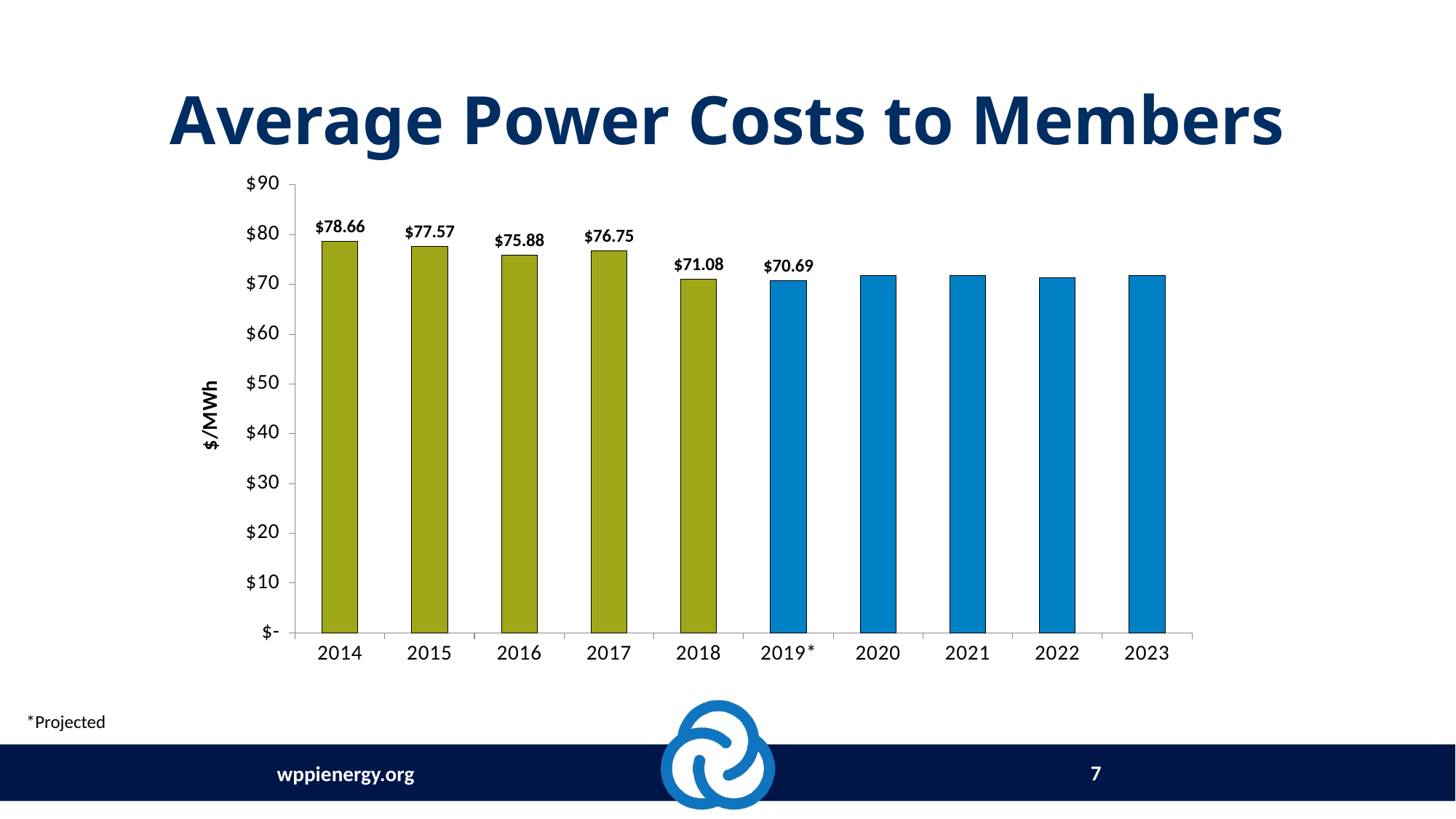
Which year has the lowest labelled average power cost? 2019* Which year has the highest average power cost among the labelled values? 2014 What is the projected average power cost to members in 2019? $70.69 What is the label on the vertical axis? $/MWh Which is larger, the average power cost in 2015 or in 2017? 2015 What kind of chart is shown on the slide? Bar chart How many years are shown on the x axis? 10 Is the value for 2021 greater or less than $60? greater What is the average power cost to members in 2016? $75.88 What is the average power cost to members in 2014? $78.66 What is the difference between the 2014 and 2018 average power costs? $7.58 What is the average power cost to members in 2018? $71.08